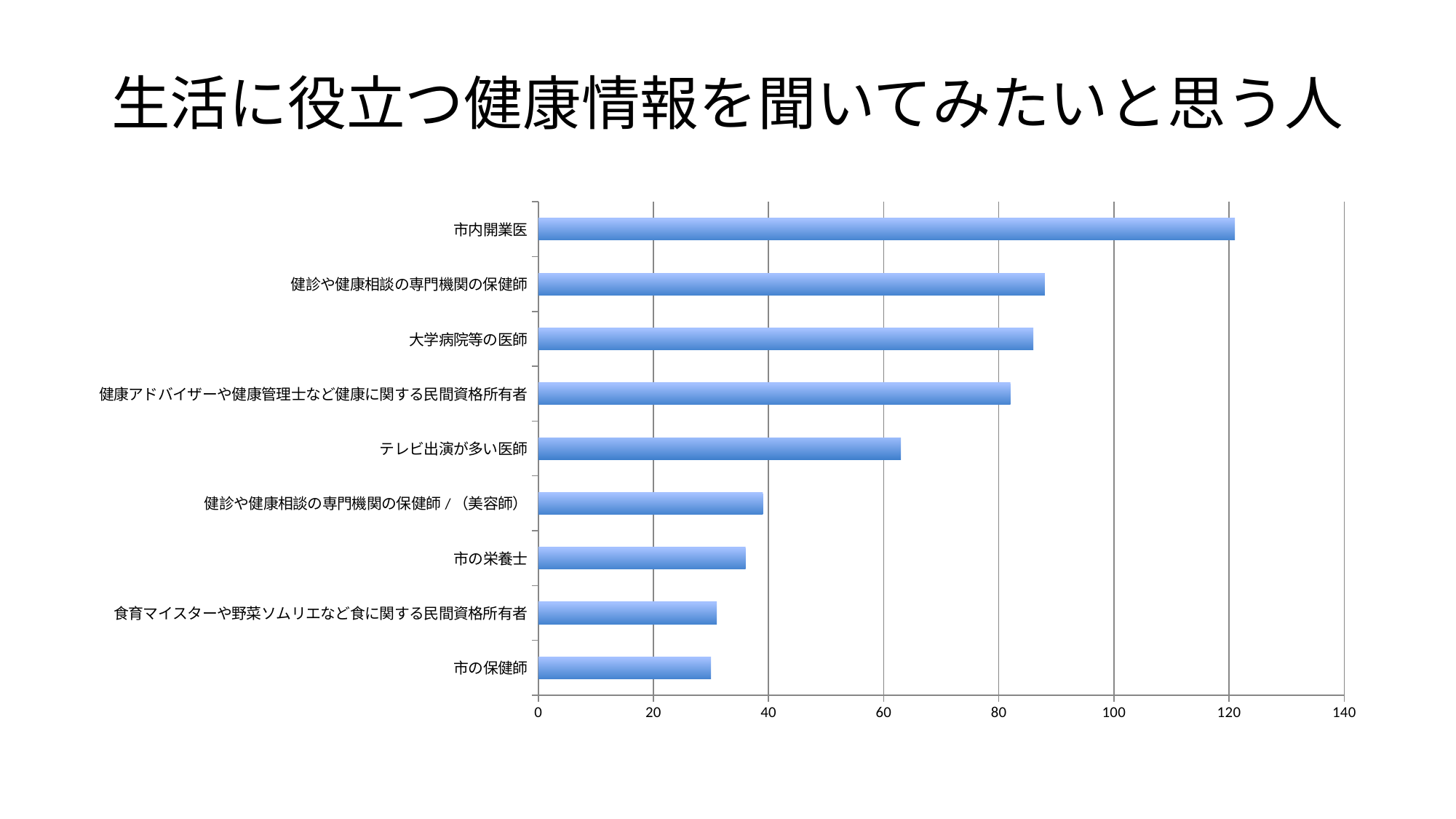
What is the maximum value shown on the horizontal axis? 140 How many categories are plotted in the chart? 9 Which is larger, the value for テレビ出演が多い医師 or the value for 市の栄養士? テレビ出演が多い医師 What is the title of the chart on the slide? 生活に役立つ健康情報を聞いてみたいと思う人 Is the value for テレビ出演が多い医師 greater or less than 80? less What kind of chart is shown on the slide? Bar chart Which is larger, the value for 市内開業医 or the value for テレビ出演が多い医師? 市内開業医 Is the value for 大学病院等の医師 greater or less than 80? greater Is the value for 市内開業医 greater or less than 100? greater Which category has the highest value? 市内開業医